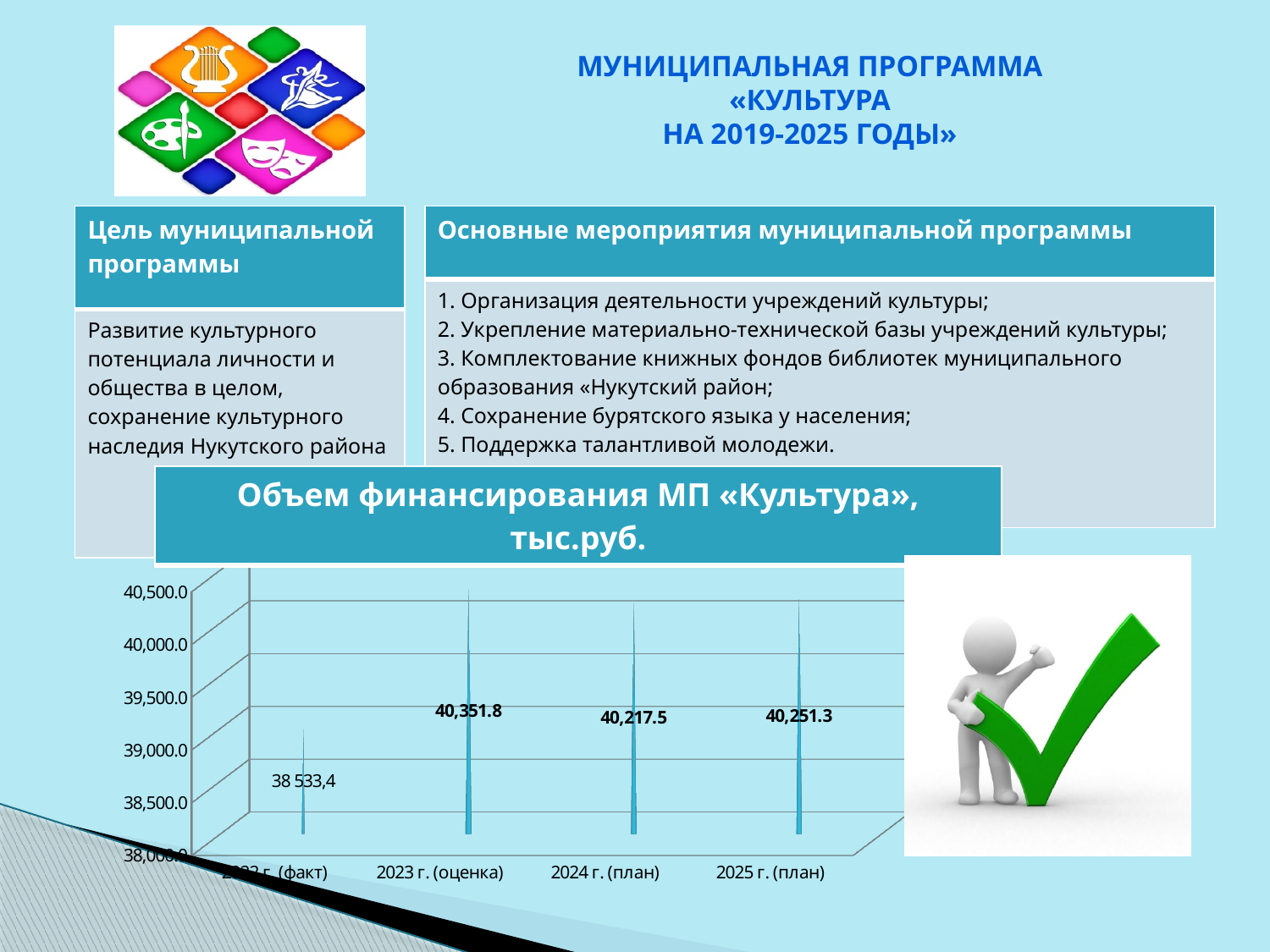
In the chart «Объем финансирования МП «Культура», тыс.руб.», what is the difference between the values for 2025 г. (план) and 2024 г. (план)? 33.8 In the chart «Объем финансирования МП «Культура», тыс.руб.», what value is labelled on the leftmost bar (2022 г. (факт))? 38 533,4 How many categories are shown in the chart «Объем финансирования МП «Культура», тыс.руб.»? 4 In the chart «Объем финансирования МП «Культура», тыс.руб.», what is the difference between the values for 2023 г. (оценка) and 2024 г. (план)? 134.3 In the chart «Объем финансирования МП «Культура», тыс.руб.», is the value for 2023 г. (оценка) greater or less than 40,000.0? greater In the chart «Объем финансирования МП «Культура», тыс.руб.», what is the value for 2024 г. (план)? 40,217.5 In the chart «Объем финансирования МП «Культура», тыс.руб.», which is larger: the value for 2024 г. (план) or 2025 г. (план)? 2025 г. (план) In the chart «Объем финансирования МП «Культура», тыс.руб.», what is the value for 2025 г. (план)? 40,251.3 In the chart «Объем финансирования МП «Культура», тыс.руб.», which category has the lowest value? 2022 г. (факт) In the chart «Объем финансирования МП «Культура», тыс.руб.», what is the value for 2023 г. (оценка)? 40,351.8 What kind of chart is «Объем финансирования МП «Культура», тыс.руб.»? bar chart In the chart «Объем финансирования МП «Культура», тыс.руб.», which category has the highest value? 2023 г. (оценка)